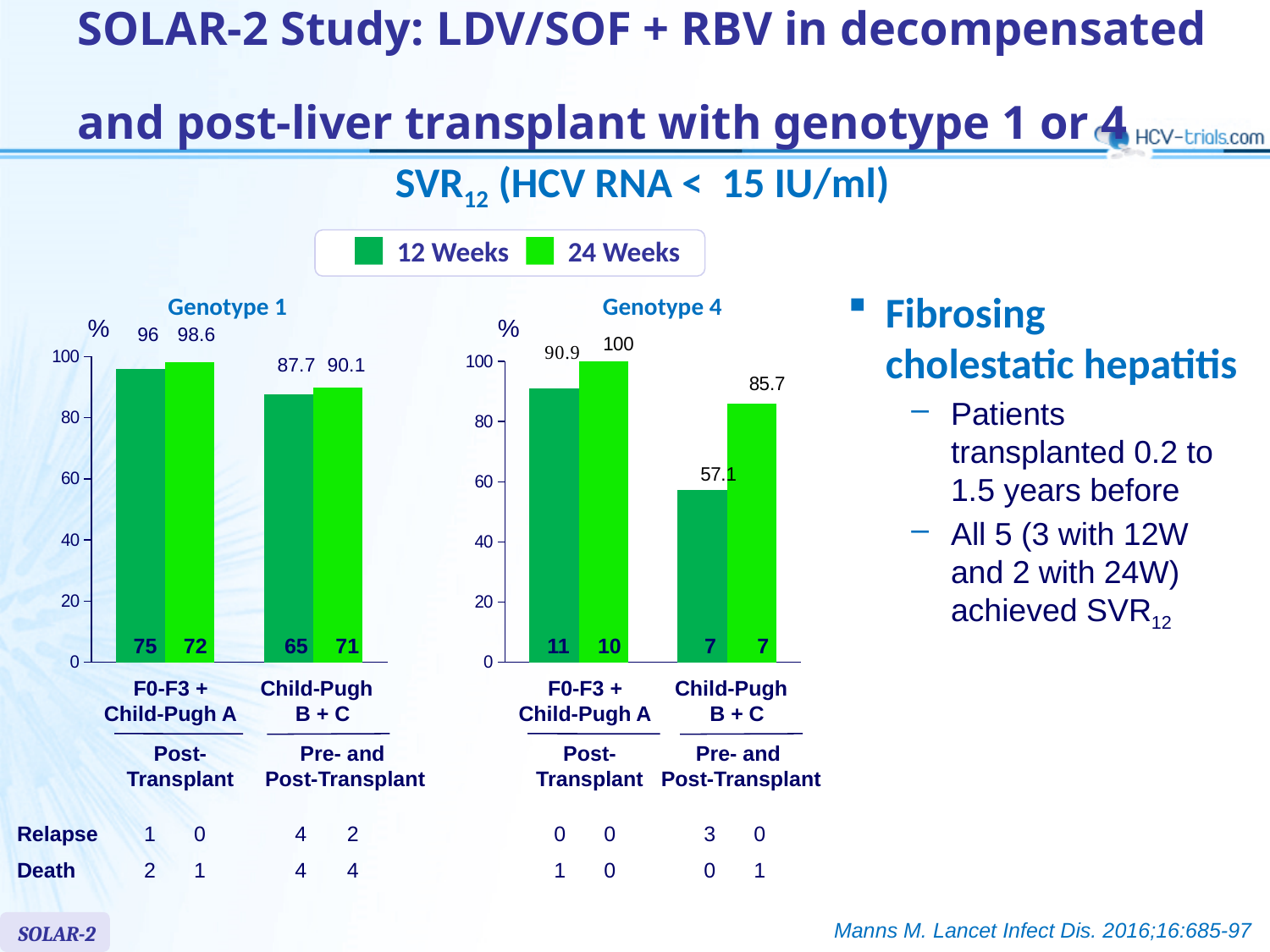
In the Genotype 1 chart, which bar has the highest value? 24 Weeks, F0-F3 + Child-Pugh A In the Genotype 4 chart, what is the SVR12 value for the 12 Weeks series in the Child-Pugh B + C group? 57.1 In the Genotype 1 chart, what is the SVR12 value for the 24 Weeks series in the Child-Pugh B + C group? 90.1 In the Genotype 4 chart, what is the difference between the 24 Weeks and 12 Weeks values in the Child-Pugh B + C group? 28.6 In the Genotype 4 chart, is the 12 Weeks value for Child-Pugh B + C greater or less than 60? less In the Genotype 1 chart, what is the difference between the 24 Weeks and 12 Weeks values in the F0-F3 + Child-Pugh A group? 2.6 In the Genotype 4 chart, which bar has the lowest value? 12 Weeks, Child-Pugh B + C In the Genotype 1 chart, which is larger: the 12 Weeks value for F0-F3 + Child-Pugh A or the 12 Weeks value for Child-Pugh B + C? F0-F3 + Child-Pugh A What type of chart is the Genotype 4 chart? Bar chart In the Genotype 1 chart, what is the SVR12 value for the 12 Weeks series in the F0-F3 + Child-Pugh A group? 96 In the Genotype 4 chart, what is the SVR12 value for the 24 Weeks series in the F0-F3 + Child-Pugh A group? 100 How many series does the legend list for the charts? 2